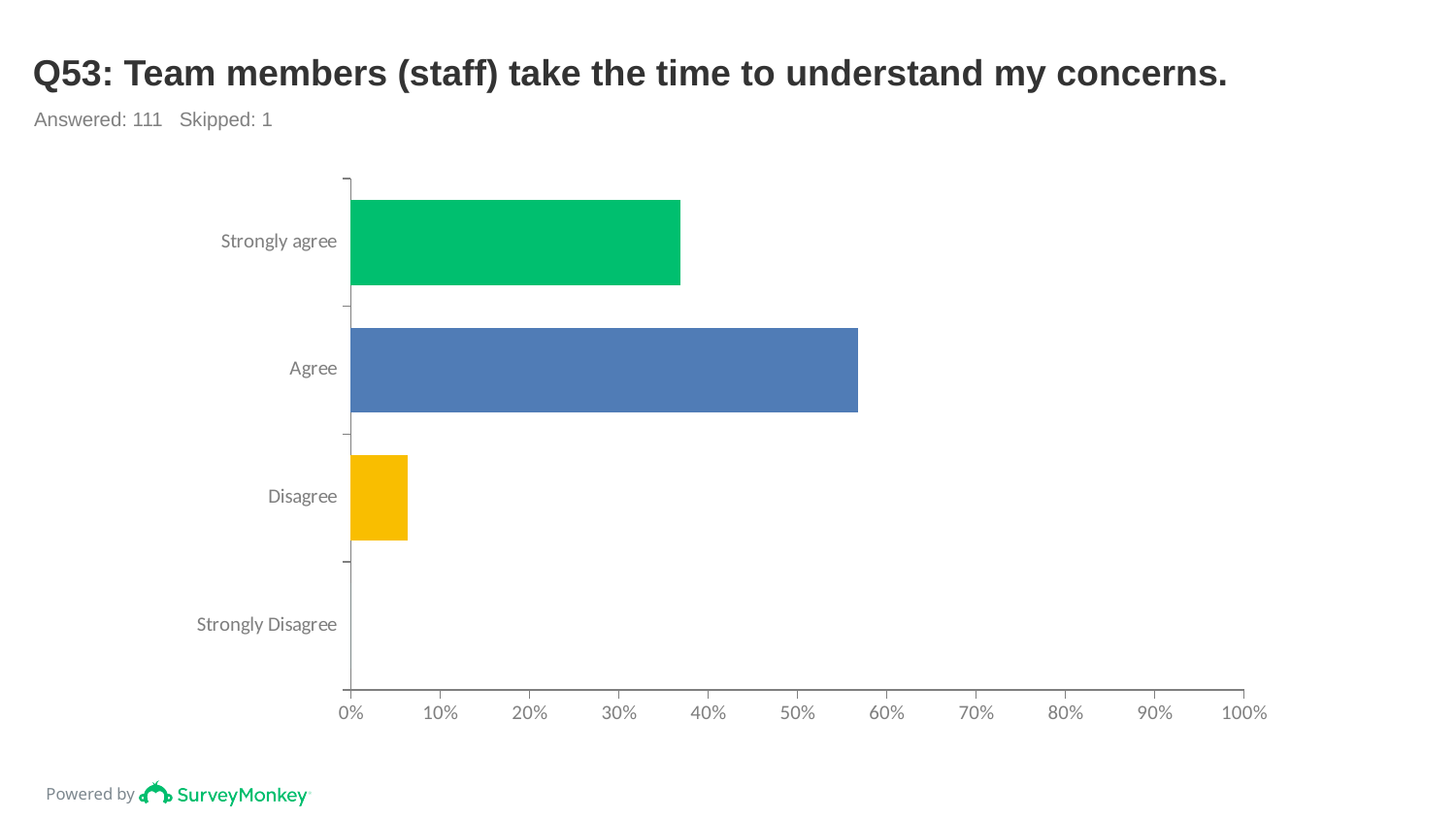
Which response category has the highest value? Agree How many response categories are shown on the chart? 4 Is the value for Disagree greater or less than 10%? less Which is larger, the value for Strongly agree or the value for Agree? Agree What kind of chart is shown on the slide? bar chart What is the title of the chart? Q53: Team members (staff) take the time to understand my concerns. Is the value for Agree greater or less than 50%? greater Which response category has the lowest value? Strongly Disagree Is the value for Strongly agree greater or less than 40%? less Which is larger, the value for Disagree or the value for Strongly agree? Strongly agree How many respondents answered the question according to the slide? 111